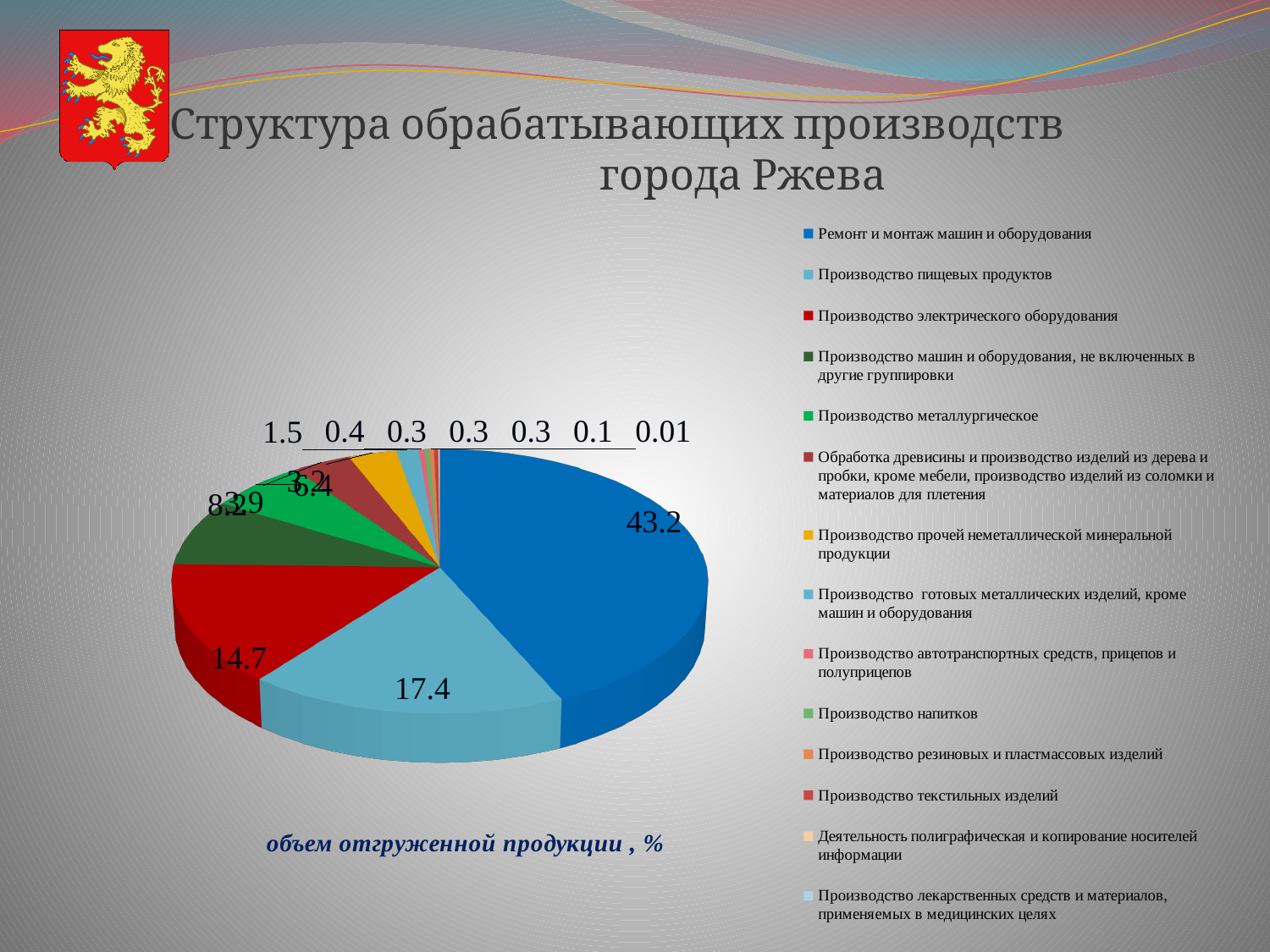
What is the value for "Ремонт и монтаж машин и оборудования"? 43.2 What is the value for "Производство пищевых продуктов"? 17.4 Which is larger: "Производство пищевых продуктов" or "Производство электрического оборудования"? Производство пищевых продуктов What kind of chart is shown on the slide? Pie chart What is the difference between the values for "Ремонт и монтаж машин и оборудования" and "Производство пищевых продуктов"? 25.8 Which category has the largest slice of the pie? Ремонт и монтаж машин и оборудования What share of the pie does the largest slice represent? 43.2% What is the value for "Производство электрического оборудования"? 14.7 What is the smallest value labeled on the pie chart? 0.01 What caption appears below the pie chart? объем отгруженной продукции , % What is the difference between the values for "Производство пищевых продуктов" and "Производство электрического оборудования"? 2.7 How many categories does the legend list? 14